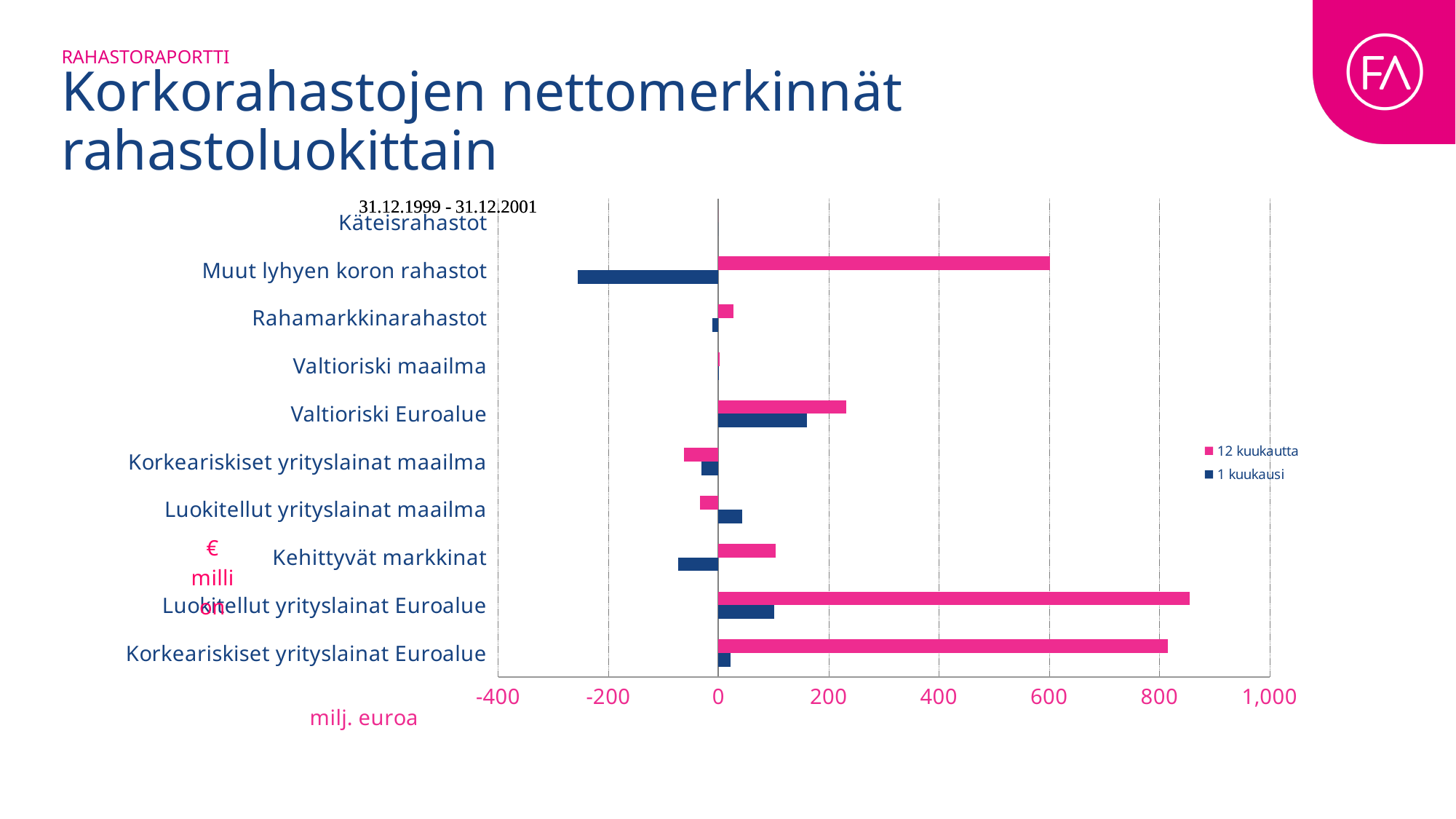
Is the 1 kuukausi value for Kehittyvät markkinat greater or less than 0? less What kind of chart is shown on the slide? bar chart Which category has the highest value for the 12 kuukautta series? Luokitellut yrityslainat Euroalue How many series does the legend list? 2 Which category has the lowest (most negative) value for the 1 kuukausi series? Muut lyhyen koron rahastot Is the 12 kuukautta value for Valtioriski Euroalue greater or less than 200? greater How many fund categories are listed on the vertical axis? 10 Which is larger for the 12 kuukautta series: Valtioriski Euroalue or Kehittyvät markkinat? Valtioriski Euroalue Which category has the highest value for the 1 kuukausi series? Valtioriski Euroalue Is the 1 kuukausi value for Muut lyhyen koron rahastot greater or less than -200? less What unit is shown on the horizontal axis of the chart? milj. euroa